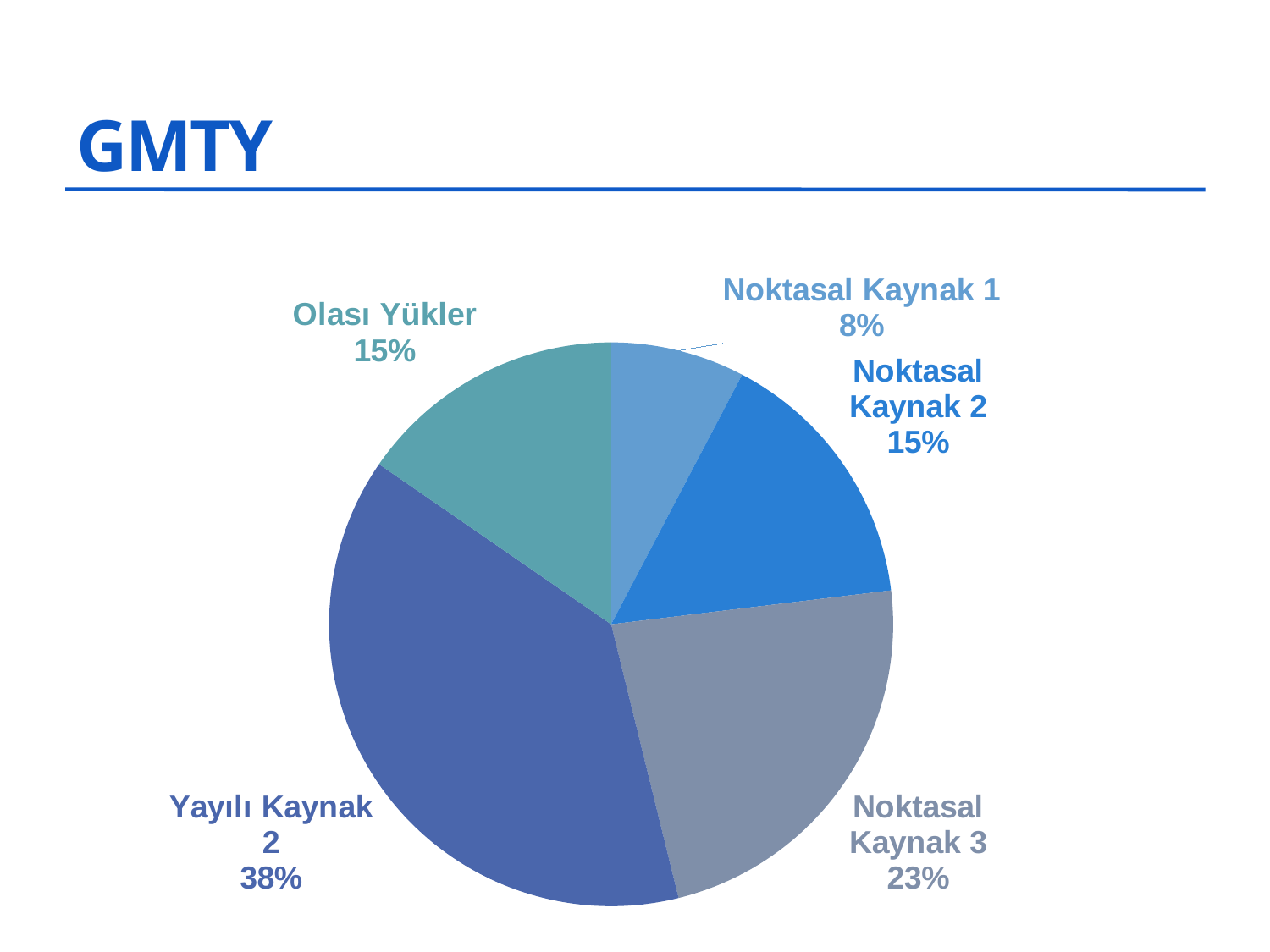
What is the difference in percentage points between Yayılı Kaynak 2 and Noktasal Kaynak 3? 15 Which is larger, Noktasal Kaynak 2 or Noktasal Kaynak 3? Noktasal Kaynak 3 What share of the pie does Noktasal Kaynak 3 have? 23% What kind of chart is shown on the slide? pie chart What share of the pie does Yayılı Kaynak 2 have? 38% Which slice of the pie is the largest? Yayılı Kaynak 2 What is the difference in percentage points between Noktasal Kaynak 2 and Noktasal Kaynak 1? 7 What share of the pie does Olası Yükler have? 15% What is the title shown above the chart on the slide? GMTY How many slices does the pie chart have? 5 Which slice of the pie is the smallest? Noktasal Kaynak 1